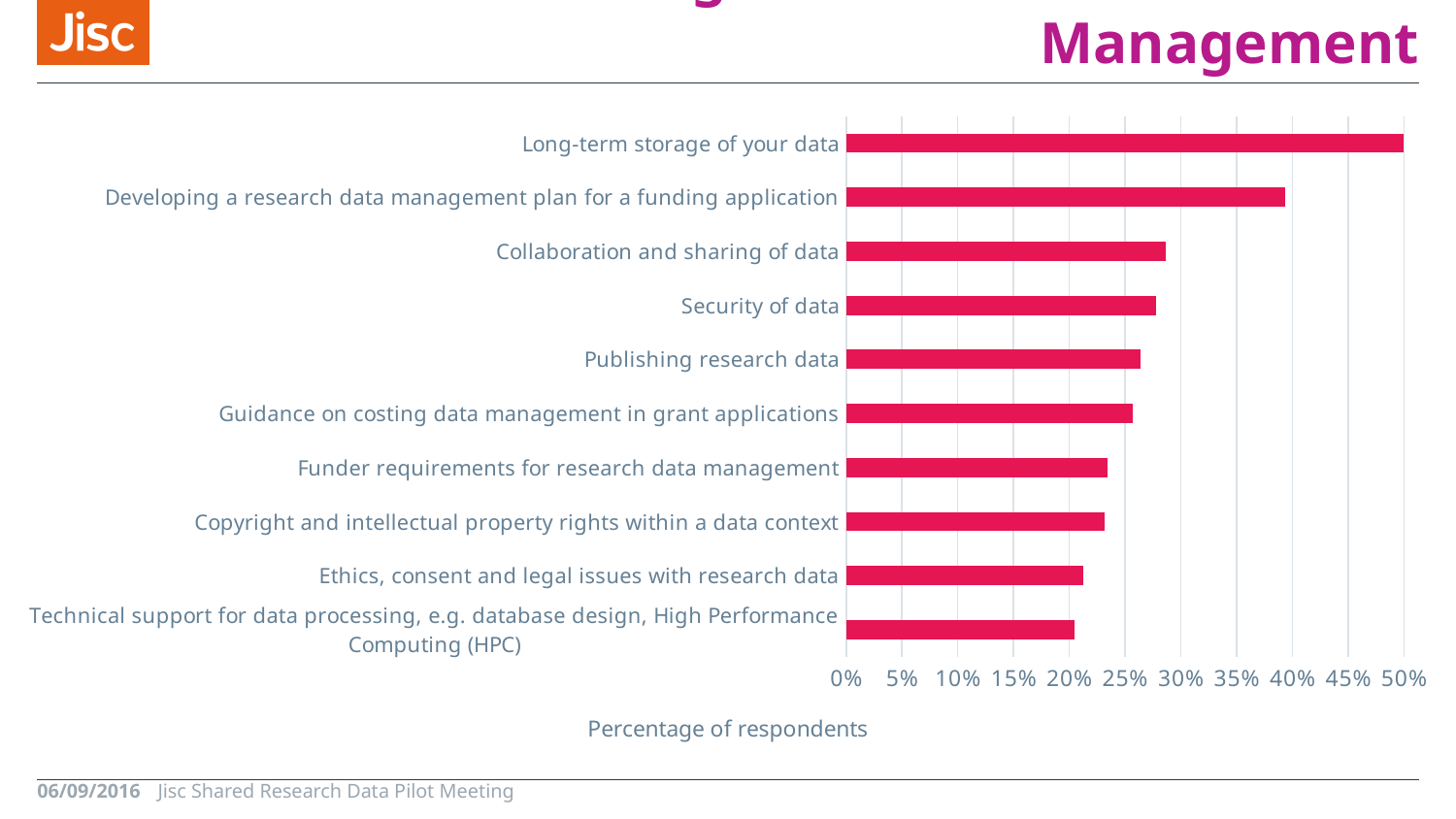
Is the value for Long-term storage of your data greater or less than 45%? greater Which is larger: the value for Publishing research data or the value for Developing a research data management plan for a funding application? Developing a research data management plan for a funding application Which category has the highest percentage of respondents? Long-term storage of your data What kind of chart is shown on the slide? bar chart Is the value for Ethics, consent and legal issues with research data greater or less than 25%? less Which category has the lowest percentage of respondents? Technical support for data processing, e.g. database design, High Performance Computing (HPC) What is the label on the horizontal axis of the chart? Percentage of respondents Do the bar values rise or fall when reading the categories from top to bottom? fall How many categories are plotted in the chart? 10 Which is larger: the value for Collaboration and sharing of data or the value for Funder requirements for research data management? Collaboration and sharing of data Is the value for Security of data greater or less than 30%? less